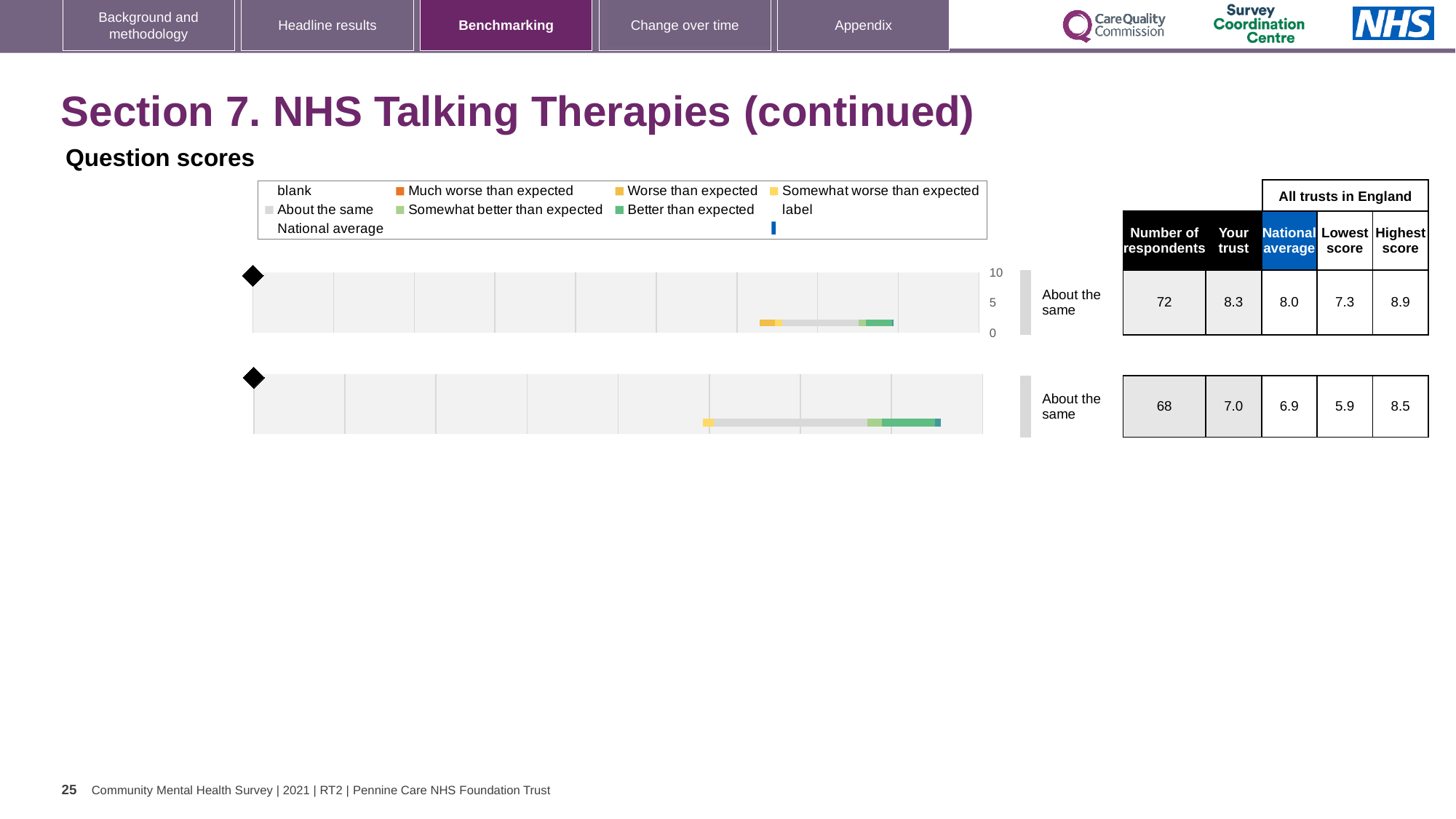
How many question rows are plotted in the Question scores chart? 2 In the first chart row, what is the 'Your trust' score? 8.3 What benchmark category label is shown next to both chart rows? About the same In the first chart row, what is the National average score? 8.0 In the second chart row, what is the Highest score among all trusts in England? 8.5 What kind of chart is used to show the question scores on this slide? bar chart Is the 'Your trust' score in the second chart row greater or less than 5? greater In the second chart row, how many respondents are there? 68 In the first chart row, what is the Lowest score among all trusts in England? 7.3 In the second chart row, what is the difference between the Highest score and the Lowest score? 2.6 In the first chart row, how much higher is the 'Your trust' score than the National average? 0.3 Which chart row has the higher 'Your trust' score, the first or the second? the first